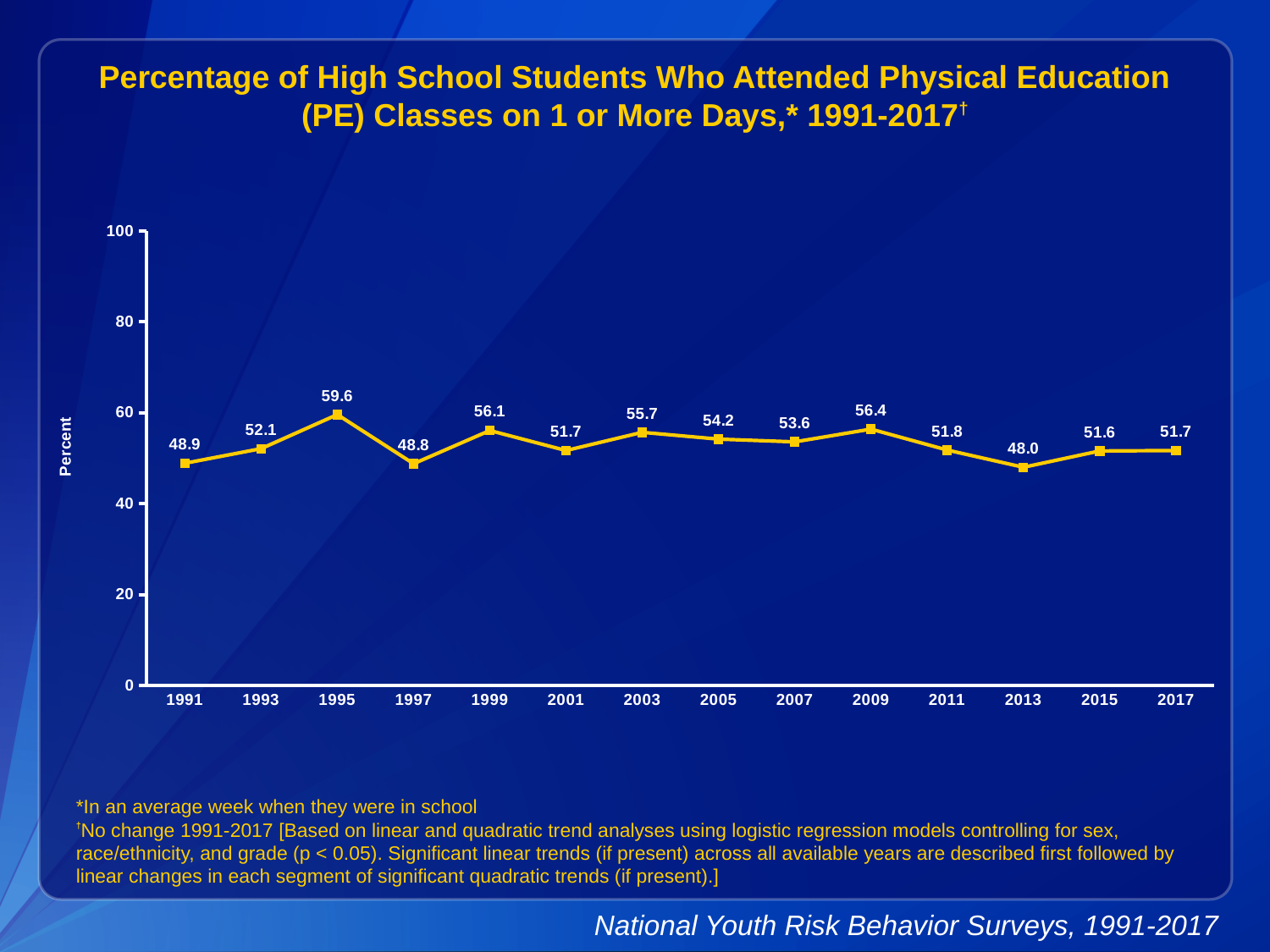
How many years are plotted on the chart? 14 Which year has the larger value, 1999 or 2001? 1999 What is the difference between the 2009 value and the 2011 value? 4.6 What kind of chart is shown on the slide? line chart What is the label on the y axis? Percent What is the value plotted for 2013? 48.0 What percentage of high school students attended PE classes on 1 or more days in 1995? 59.6 Is the value for 2003 greater or less than 60? less What is the difference between the 1995 value and the 2013 value? 11.6 Which year has the lowest percentage? 2013 Which year has the highest percentage? 1995 What is the value plotted for 2017? 51.7